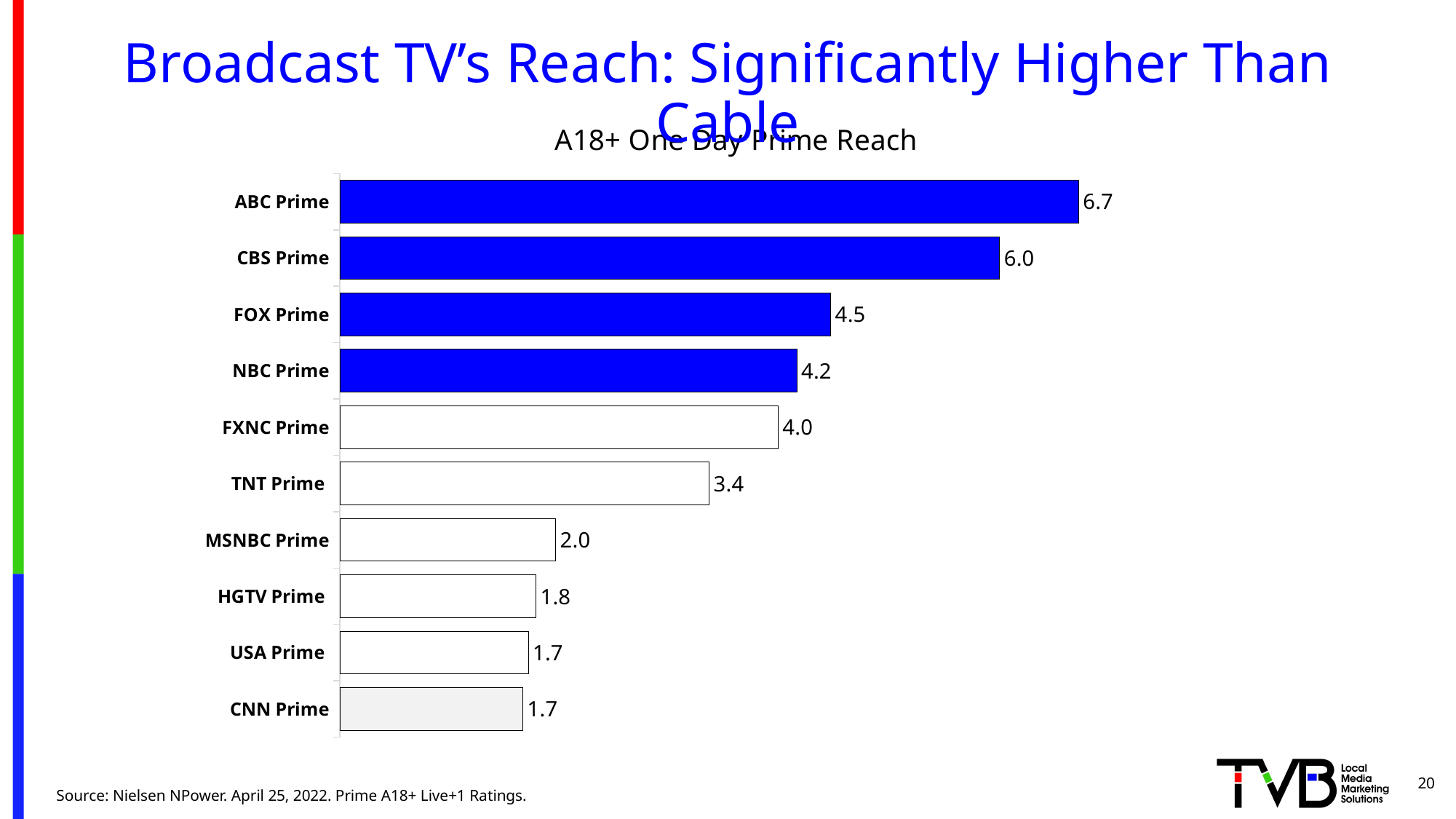
What is the title of the chart? A18+ One Day Prime Reach What is the A18+ one day prime reach value for ABC Prime? 6.7 What is the value shown for HGTV Prime? 1.8 What is the difference between the values for ABC Prime and CBS Prime? 0.7 What is the difference between the values for FOX Prime and TNT Prime? 1.1 Which category has the highest value in the chart? ABC Prime What is the value shown for FXNC Prime? 4.0 Which has a larger value, MSNBC Prime or TNT Prime? TNT Prime How many bars in the chart are filled in solid blue? 4 What kind of chart is shown on the slide? Bar chart How many categories are plotted in the chart? 10 Which has a larger value, NBC Prime or FXNC Prime? NBC Prime